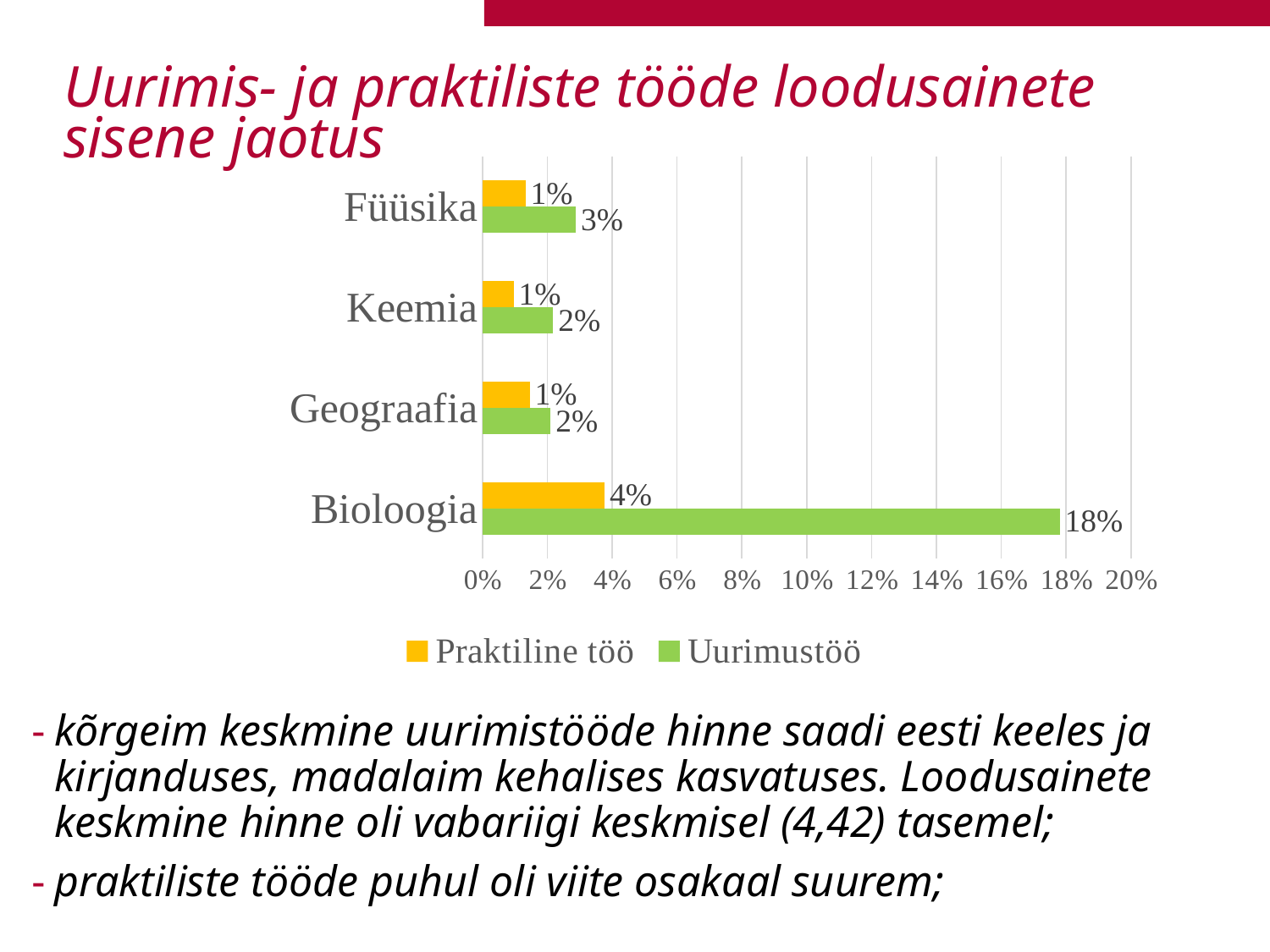
Is the Uurimustöö value for Bioloogia greater or less than 10%? greater Which is larger: the Uurimustöö value for Bioloogia or the Uurimustöö value for Füüsika? Bioloogia What kind of chart is shown on the slide? bar chart What is the Uurimustöö value for Füüsika? 3% What is the Praktiline töö value for Keemia? 1% How many categories are shown on the chart? 4 Which category has the highest Uurimustöö value? Bioloogia How many series does the legend list? 2 What is the Praktiline töö value for Bioloogia? 4% What is the difference between the Uurimustöö and Praktiline töö values for Bioloogia? 14% What is the Uurimustöö value for Bioloogia? 18% Which category has the highest Praktiline töö value? Bioloogia